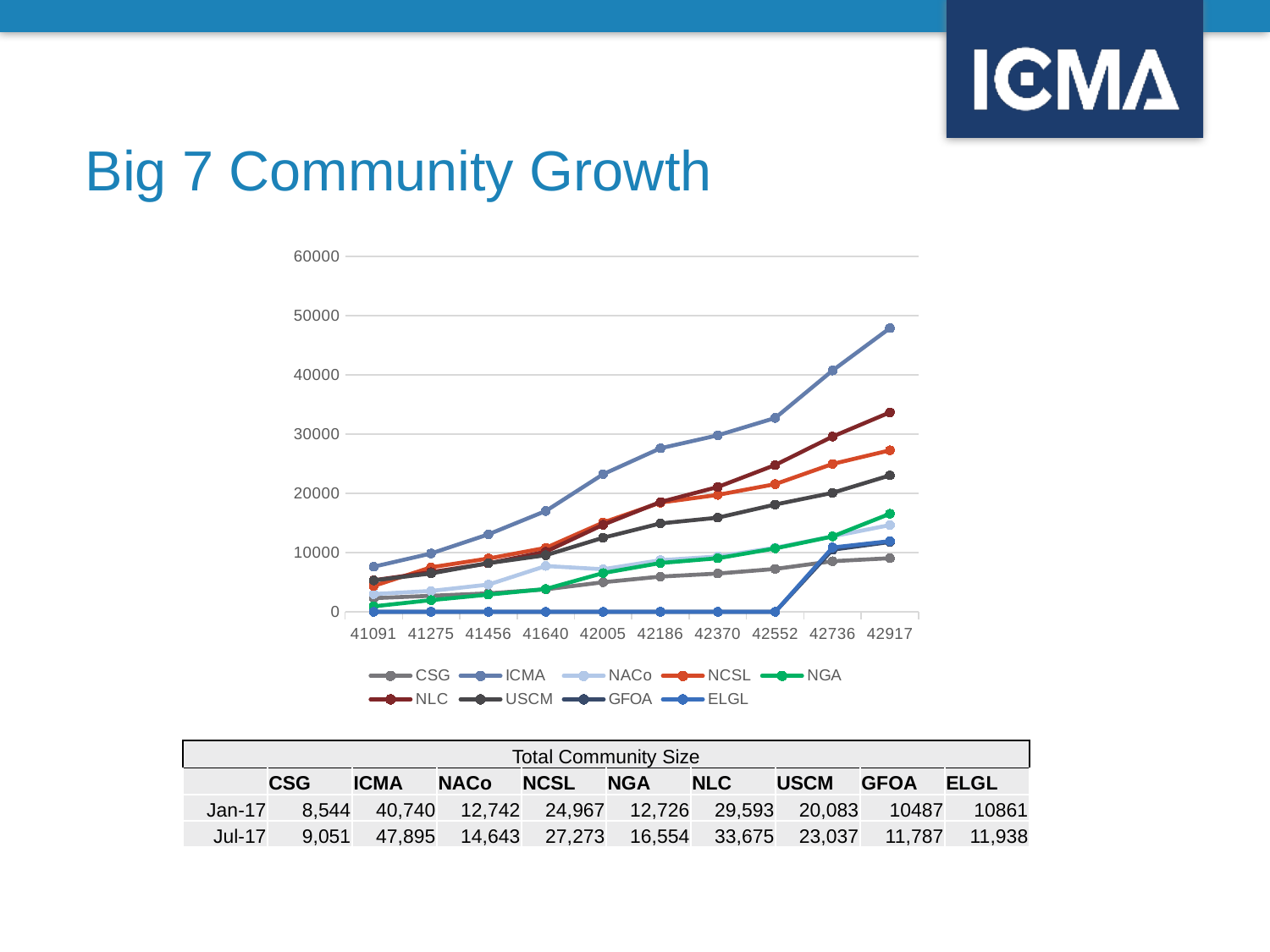
Which series has the highest value at the last x-axis point (42917)? ICMA According to the Total Community Size table, what is the NGA value for Jan-17? 12,726 Using the Total Community Size table, by how much did the ICMA value increase from Jan-17 to Jul-17? 7,155 Is the value for ICMA at 42917 greater or less than 40000? greater How many points are there along the x axis of the chart? 10 Does the ICMA line rise or fall from 41091 to 42917? rises What kind of chart is shown on the slide? line chart Is the value for ELGL at 42552 greater or less than 10000? less According to the Total Community Size table, what is the ICMA value for Jul-17? 47,895 At 42917, which series is larger, NLC or NCSL? NLC How many series does the chart legend list? 9 Which series has the lowest value at the last x-axis point (42917)? CSG